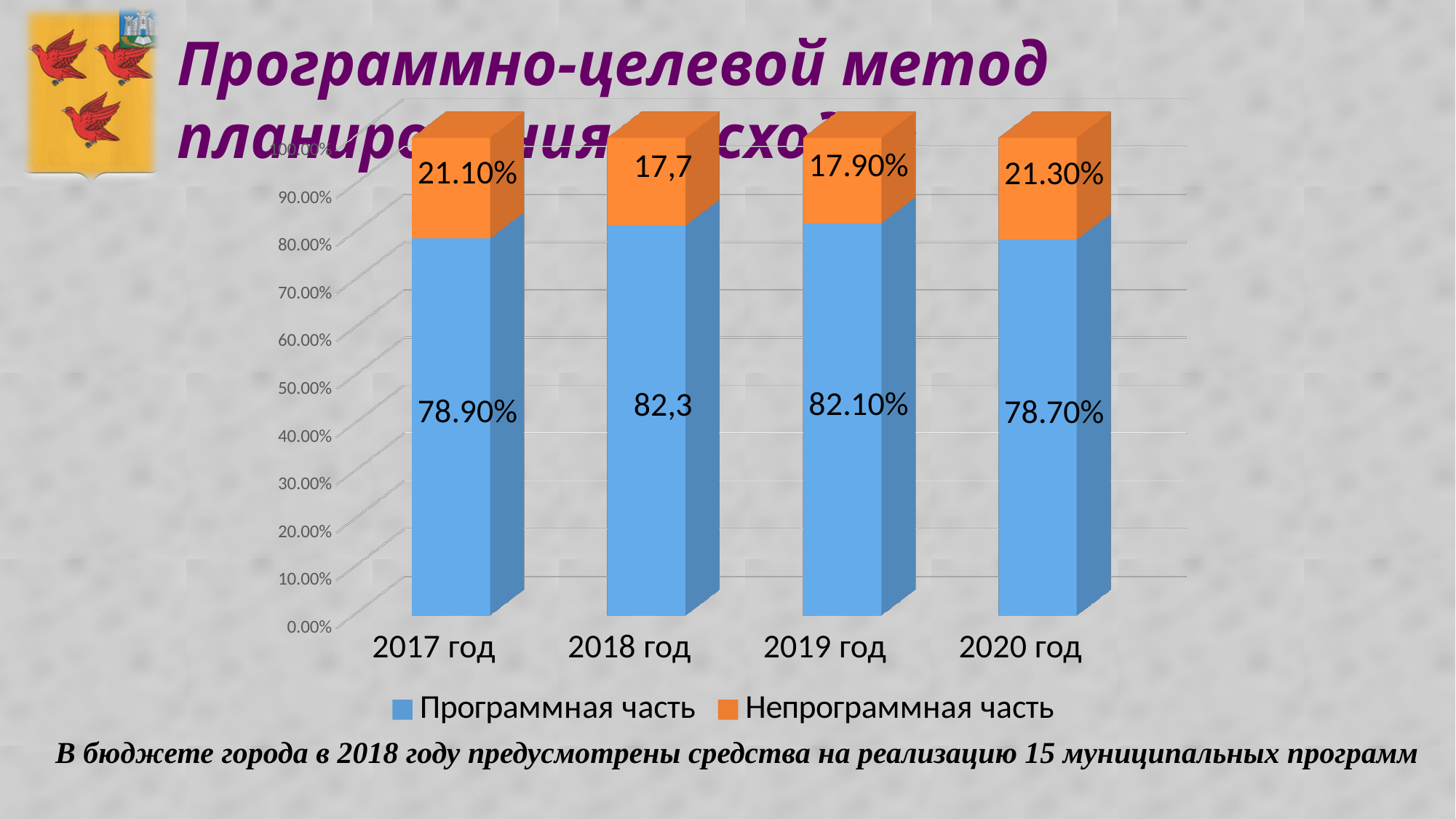
Which is larger: Программная часть for 2019 год or for 2020 год? 2019 год How many years are shown on the x axis? 4 What is the value of Программная часть for 2018 год? 82,3 How many series does the legend list? 2 What is the value of Непрограммная часть for 2019 год? 17.90% What kind of chart is shown on the slide? Stacked bar chart What is the value of Непрограммная часть for 2020 год? 21.30% What is the difference between the Непрограммная часть values for 2020 год and 2019 год? 3.40% What is the value of Программная часть for 2017 год? 78.90% Which colour represents Непрограммная часть in the chart? Orange